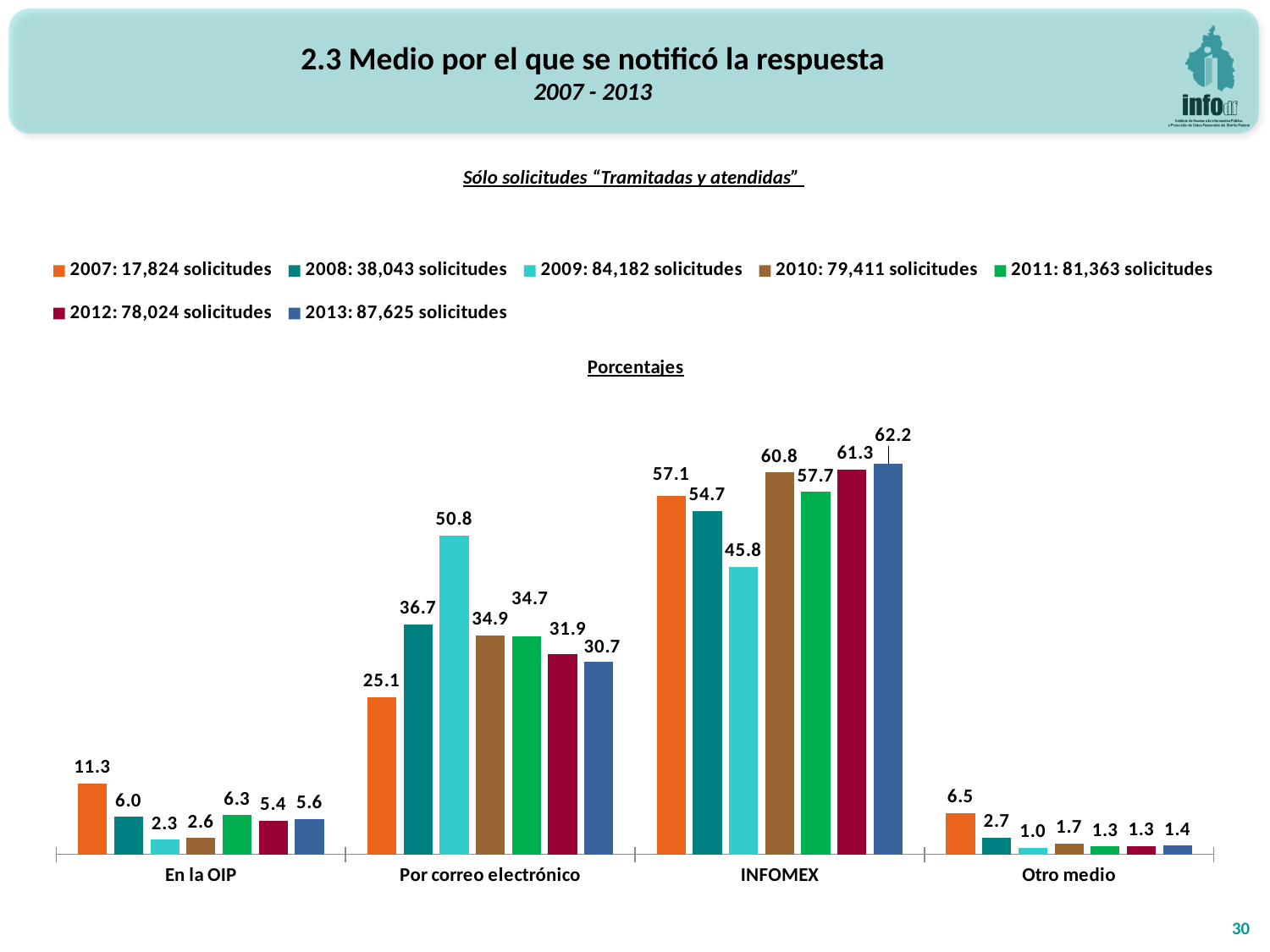
What is the value for 2007 in the En la OIP category? 11.3 How many series does the legend list? 7 What is the value for 2013 in the INFOMEX category? 62.2 Do the values for the Otro medio category rise or fall from 2007 to 2009? fall What is the value for 2009 in the Por correo electrónico category? 50.8 What is the difference between the 2013 and 2007 values in the INFOMEX category? 5.1 According to the legend, how many solicitudes were there in 2013? 87,625 What type of chart is shown on the slide? bar chart How many categories are shown on the x axis? 4 Which is larger in the Por correo electrónico category, the value for 2008 or the value for 2010? 2008 Which year has the lowest value in the Otro medio category? 2009 Which year has the highest value in the INFOMEX category? 2013